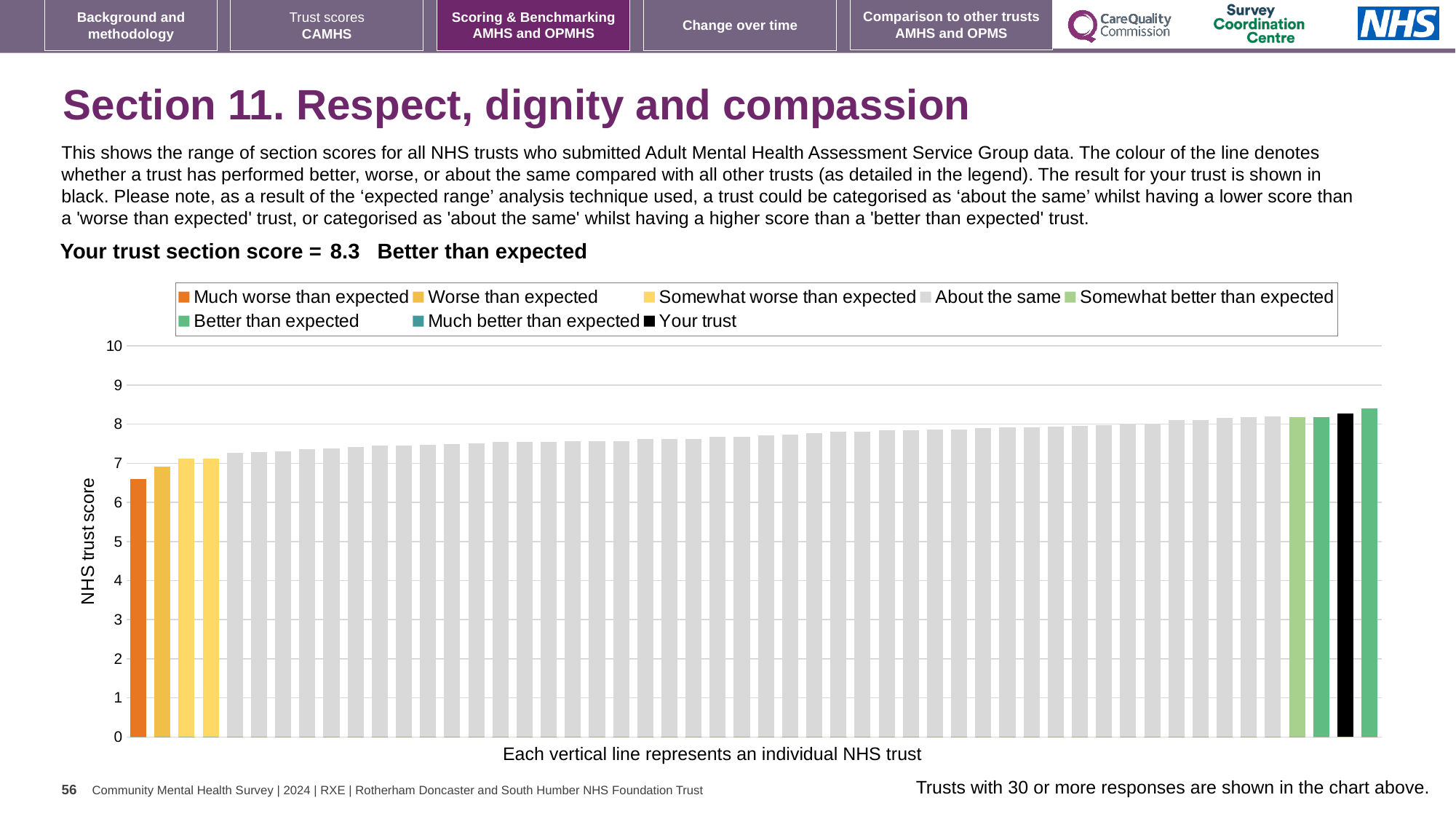
What is the title of the y axis? NHS trust score Is the value for your trust greater or less than 8? greater What is the section score for your trust? 8.3 Do the bar values rise or fall from left to right along the x axis? rise How many bars are coloured as 'Much worse than expected'? 1 Is the value of the tallest bar in the chart greater or less than 9? less What colour is the bar representing your trust? Black Which is larger: the bar for your trust or the bar for the 'Much worse than expected' trust? Your trust Is the value for the 'Somewhat better than expected' trust greater or less than 8? greater What kind of chart is shown on the slide? Bar chart How many categories does the chart legend list? 8